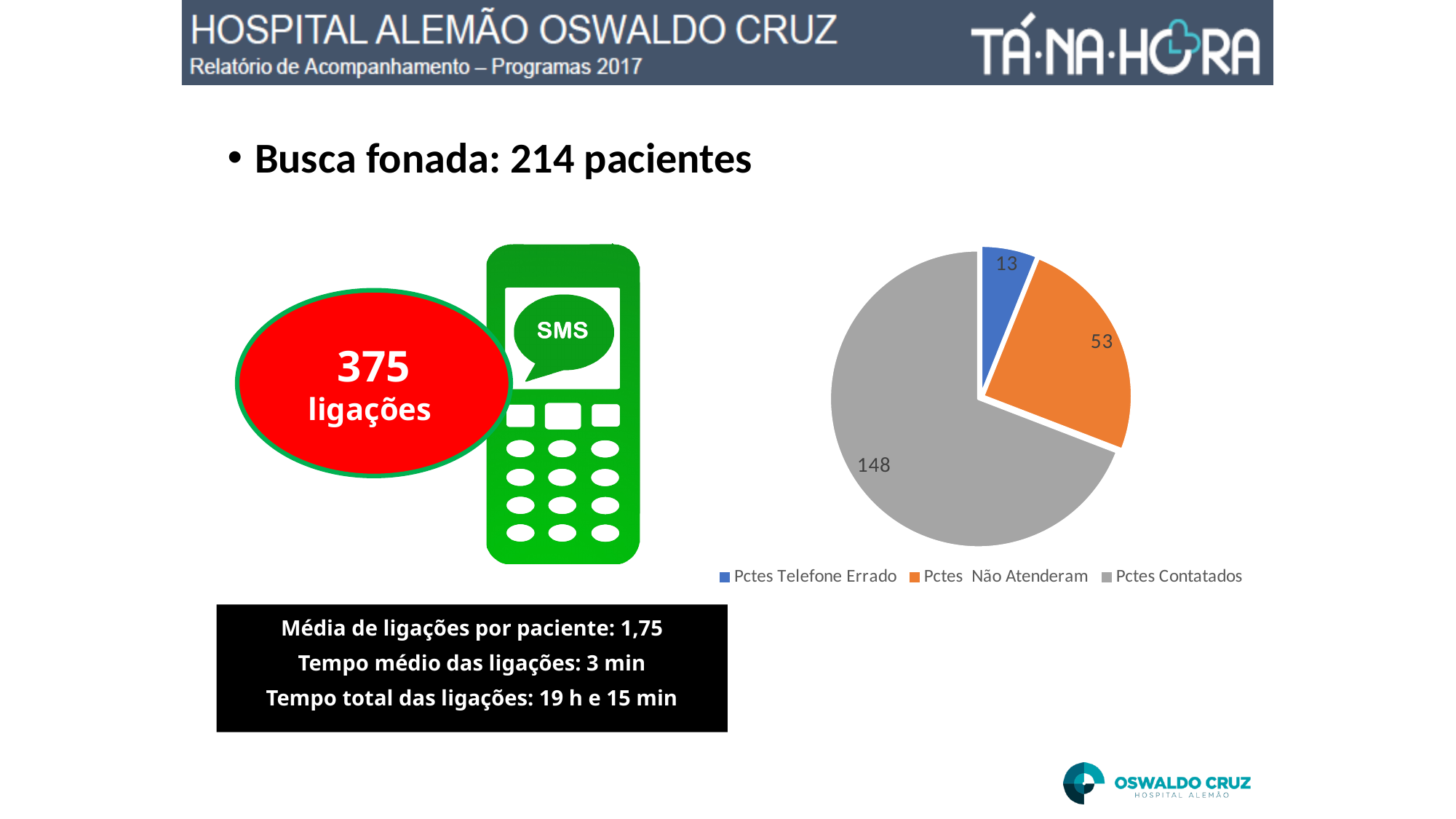
What is the value for Pctes Contatados in the pie chart? 148 Which is larger in the pie chart: Pctes Não Atenderam or Pctes Telefone Errado? Pctes Não Atenderam What is the difference between the values for Pctes Contatados and Pctes Não Atenderam? 95 Which category has the largest slice in the pie chart? Pctes Contatados What is the value for Pctes Não Atenderam in the pie chart? 53 What is the total of all slices in the pie chart? 214 How many entries does the pie chart's legend list? 3 Which category has the smallest slice in the pie chart? Pctes Telefone Errado What kind of chart is shown on the slide? pie chart How many slices does the pie chart have? 3 Which colour represents Pctes Não Atenderam in the pie chart? orange What is the value for Pctes Telefone Errado in the pie chart? 13